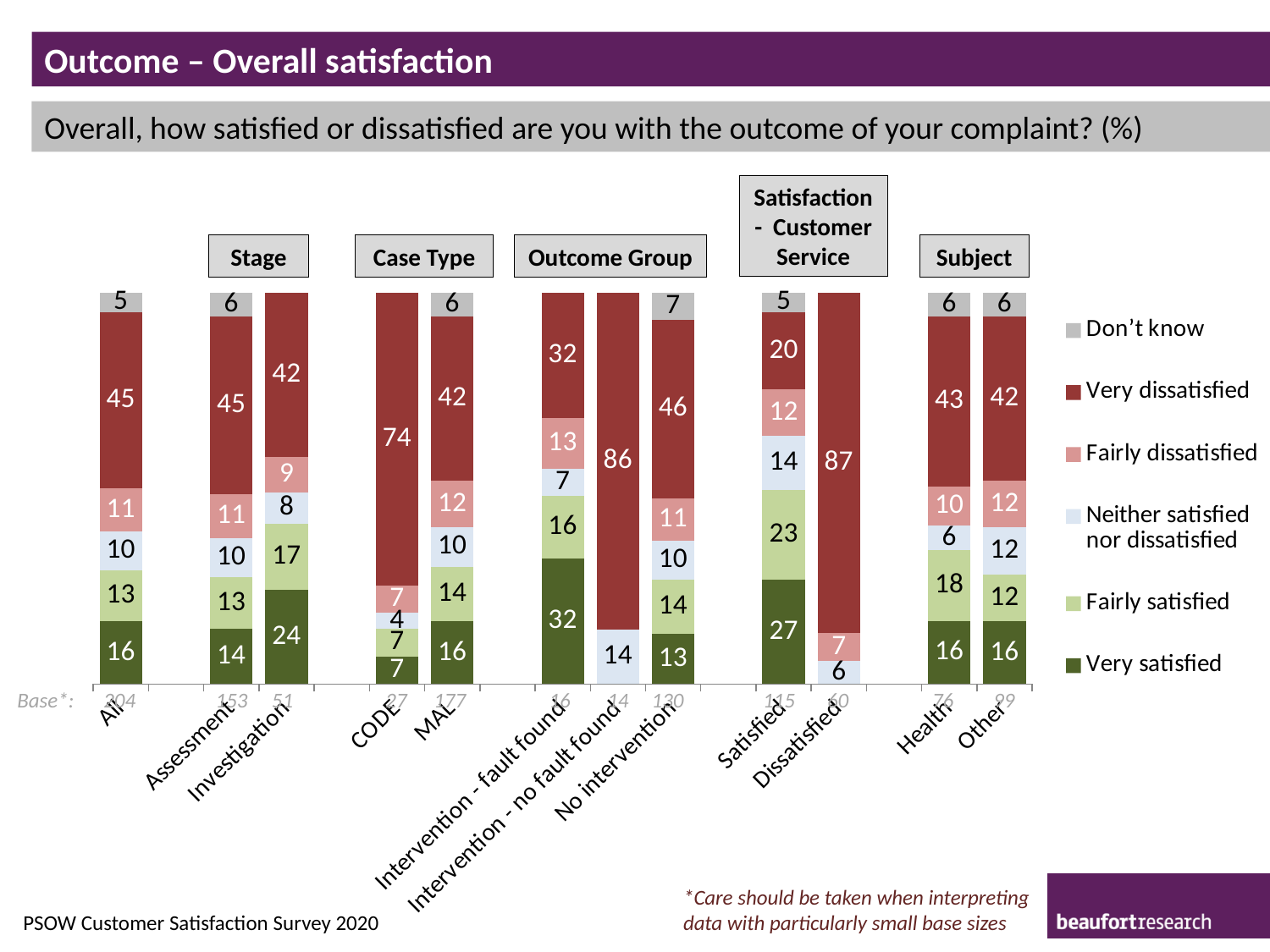
What is the Very dissatisfied value for the All category? 45 What is the Fairly satisfied value for Health? 18 What is the Very satisfied value for Investigation? 24 Which category has the highest Very dissatisfied value? Dissatisfied What is the total of the labelled segments in the All bar? 100 What is the Very dissatisfied value for CODE? 74 What kind of chart is shown on the slide? Stacked bar chart How many series does the legend list? 6 Which is larger, the Very satisfied value for Satisfied or for MAL? Satisfied Which category has the highest Very satisfied value? Intervention - fault found How many categories are shown along the x axis? 12 What is the difference between the Very dissatisfied values for Dissatisfied and Satisfied? 67